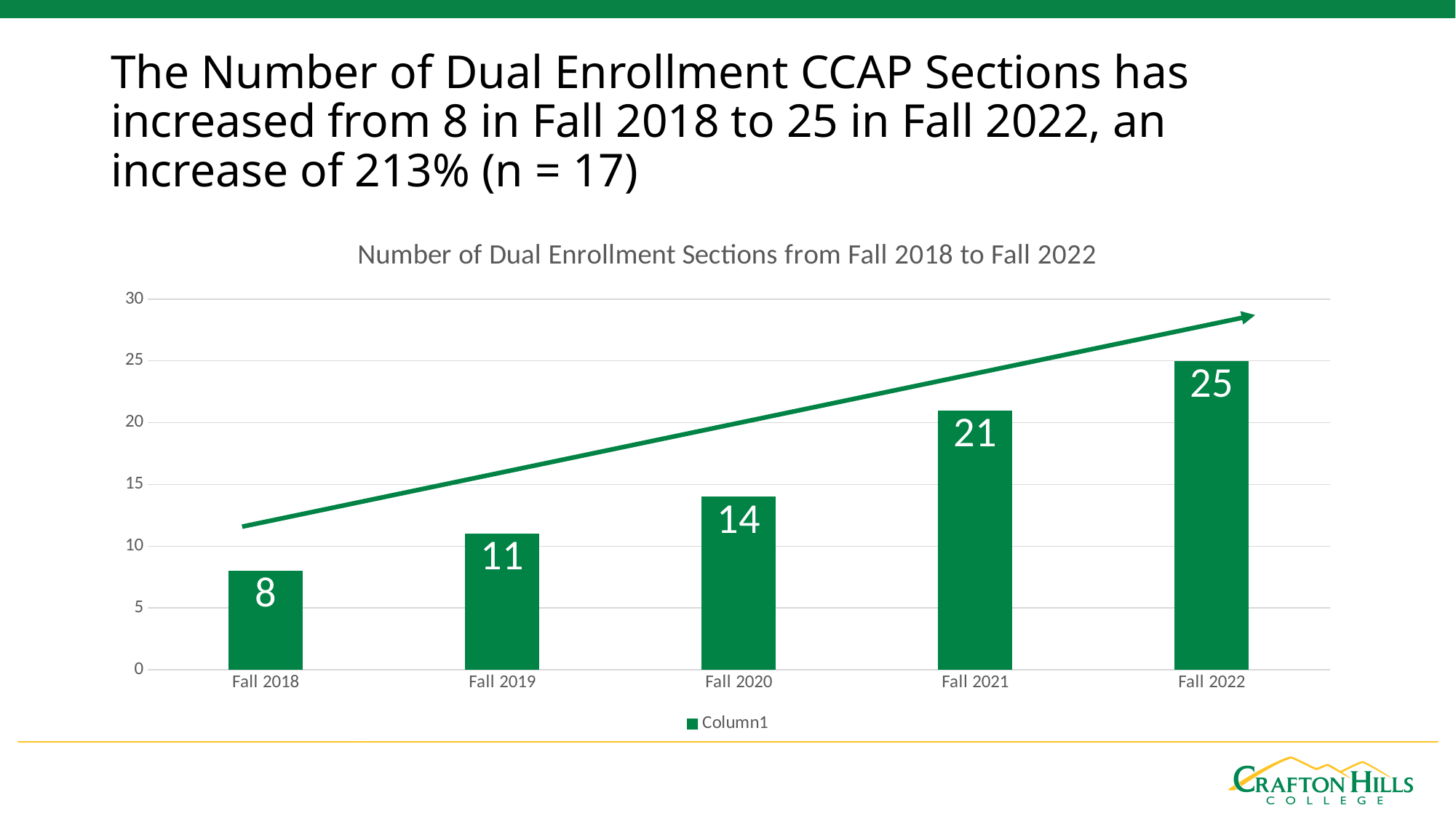
What is the number of dual enrollment sections for Fall 2021? 21 What is the difference between the number of sections in Fall 2022 and Fall 2018? 17 Which has more dual enrollment sections, Fall 2019 or Fall 2020? Fall 2020 What is the number of dual enrollment sections for Fall 2018? 8 Which term has the lowest number of dual enrollment sections? Fall 2018 What kind of chart is shown on the slide? Bar chart Do the values rise or fall from Fall 2018 to Fall 2022? Rise How many terms are shown on the x axis of the chart? 5 What is the number of dual enrollment sections for Fall 2020? 14 What is the title of the chart? Number of Dual Enrollment Sections from Fall 2018 to Fall 2022 What is the difference between the number of sections in Fall 2021 and Fall 2019? 10 Which term has the highest number of dual enrollment sections? Fall 2022